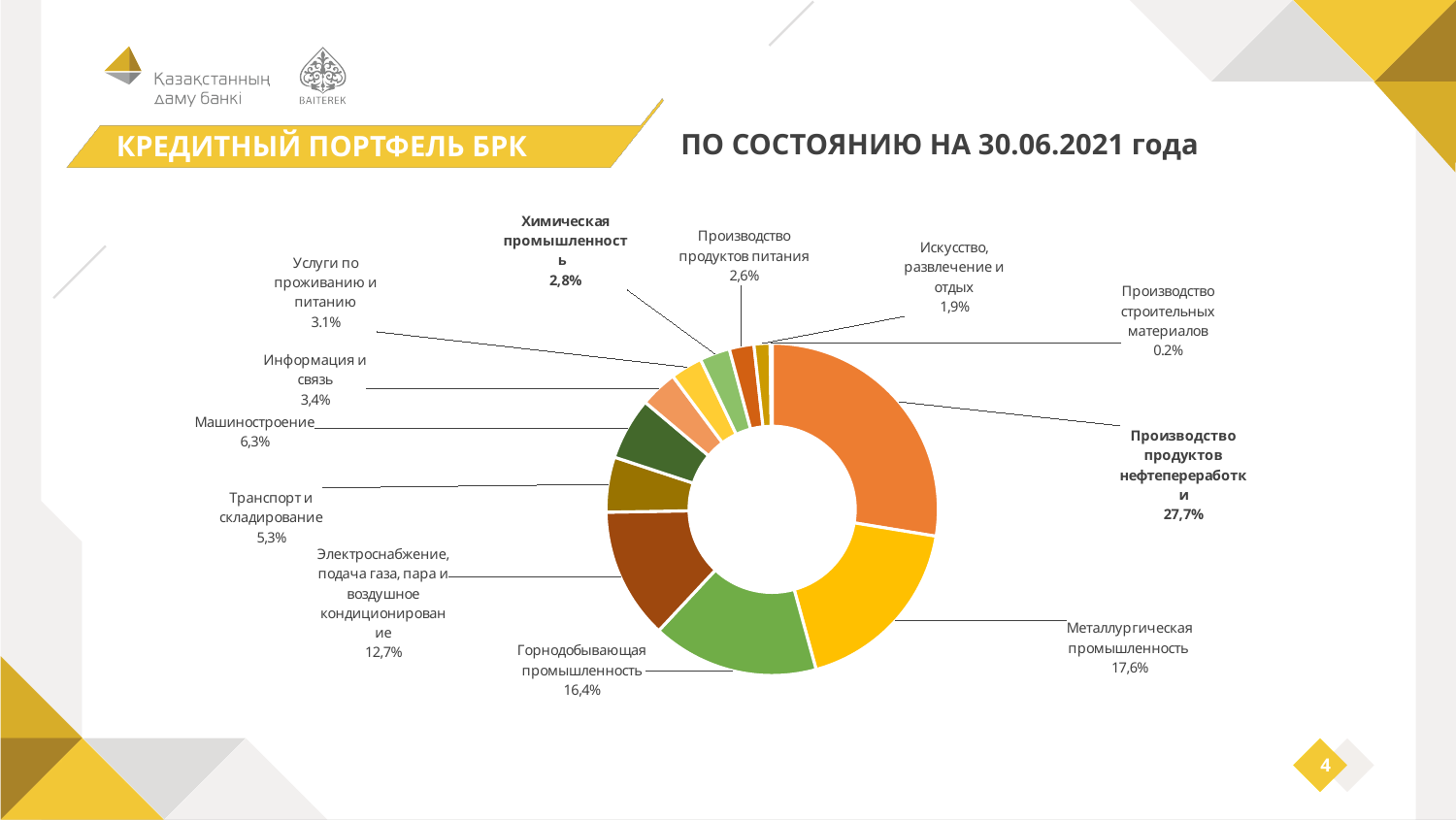
What share is shown for Металлургическая промышленность? 17,6% Which sector has the largest share of the credit portfolio? Производство продуктов нефтепереработки What share of the credit portfolio is Производство продуктов нефтепереработки? 27,7% What is the difference in share between Металлургическая промышленность and Горнодобывающая промышленность? 1,2 percentage points Which sector has the smallest share of the credit portfolio? Производство строительных материалов How many sectors are shown in the chart? 12 What kind of chart is shown on the slide? Doughnut (pie) chart What share is shown for Электроснабжение, подача газа, пара и воздушное кондиционирование? 12,7% As of what date is the credit portfolio shown? 30.06.2021 What share is shown for Горнодобывающая промышленность? 16,4% What share is shown for Машиностроение? 6,3% Which has a larger share: Транспорт и складирование or Машиностроение? Машиностроение